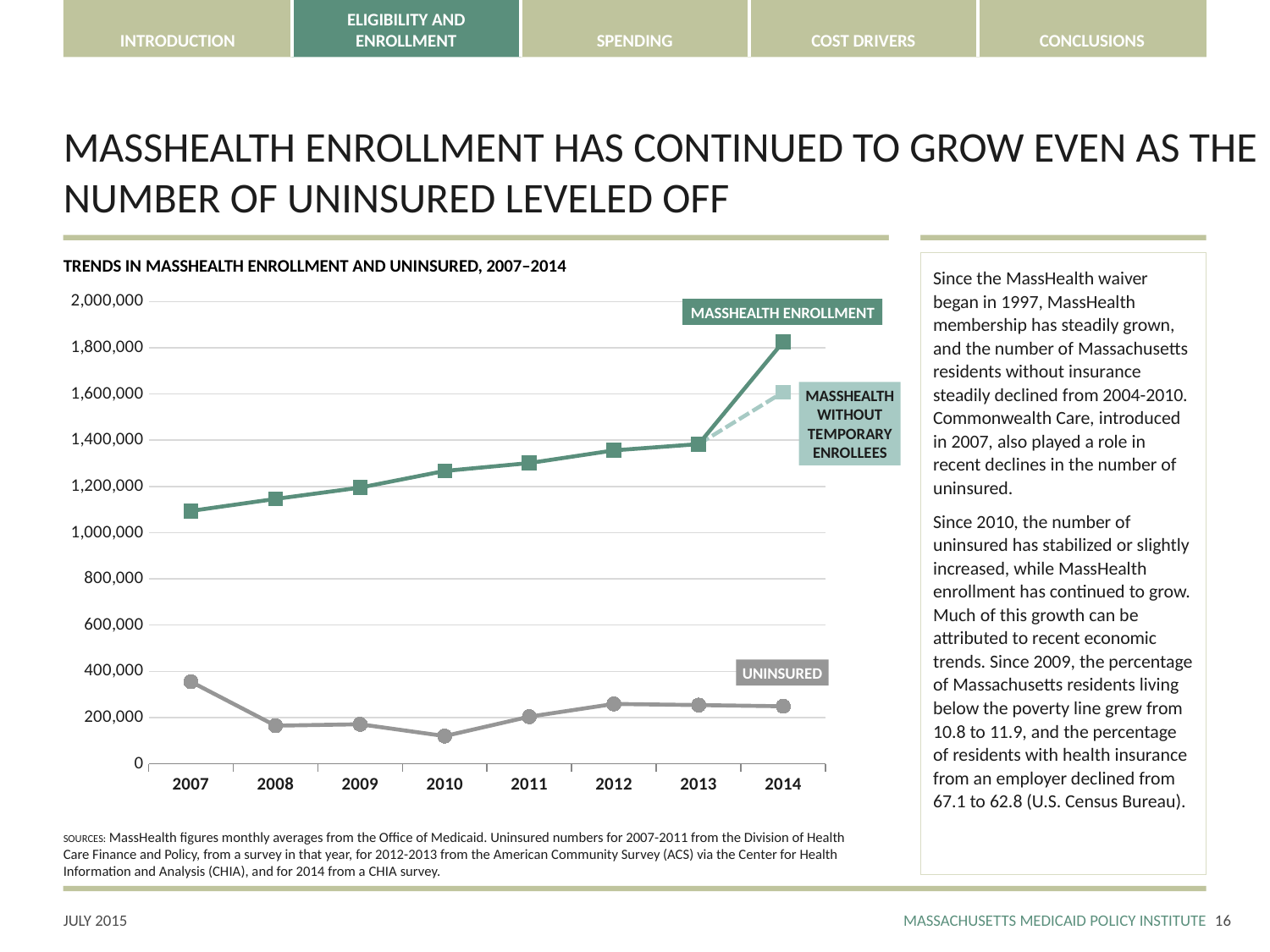
Is the uninsured value for 2010 greater or less than 200,000? less In which year is MassHealth enrollment highest? 2014 In which year is the number of uninsured highest? 2007 Is the MassHealth enrollment value for 2014 greater or less than 1,600,000? greater In which year is MassHealth enrollment lowest? 2007 What is the title of the chart? Trends in MassHealth Enrollment and Uninsured, 2007–2014 In which year is the number of uninsured lowest? 2010 How many years are plotted along the x axis of the chart? 8 How many labeled series does the chart show? 3 What kind of chart is shown on the slide? line chart Which is larger in 2014, MassHealth enrollment or the number of uninsured? MassHealth enrollment Does MassHealth enrollment rise or fall from 2007 to 2014? rise